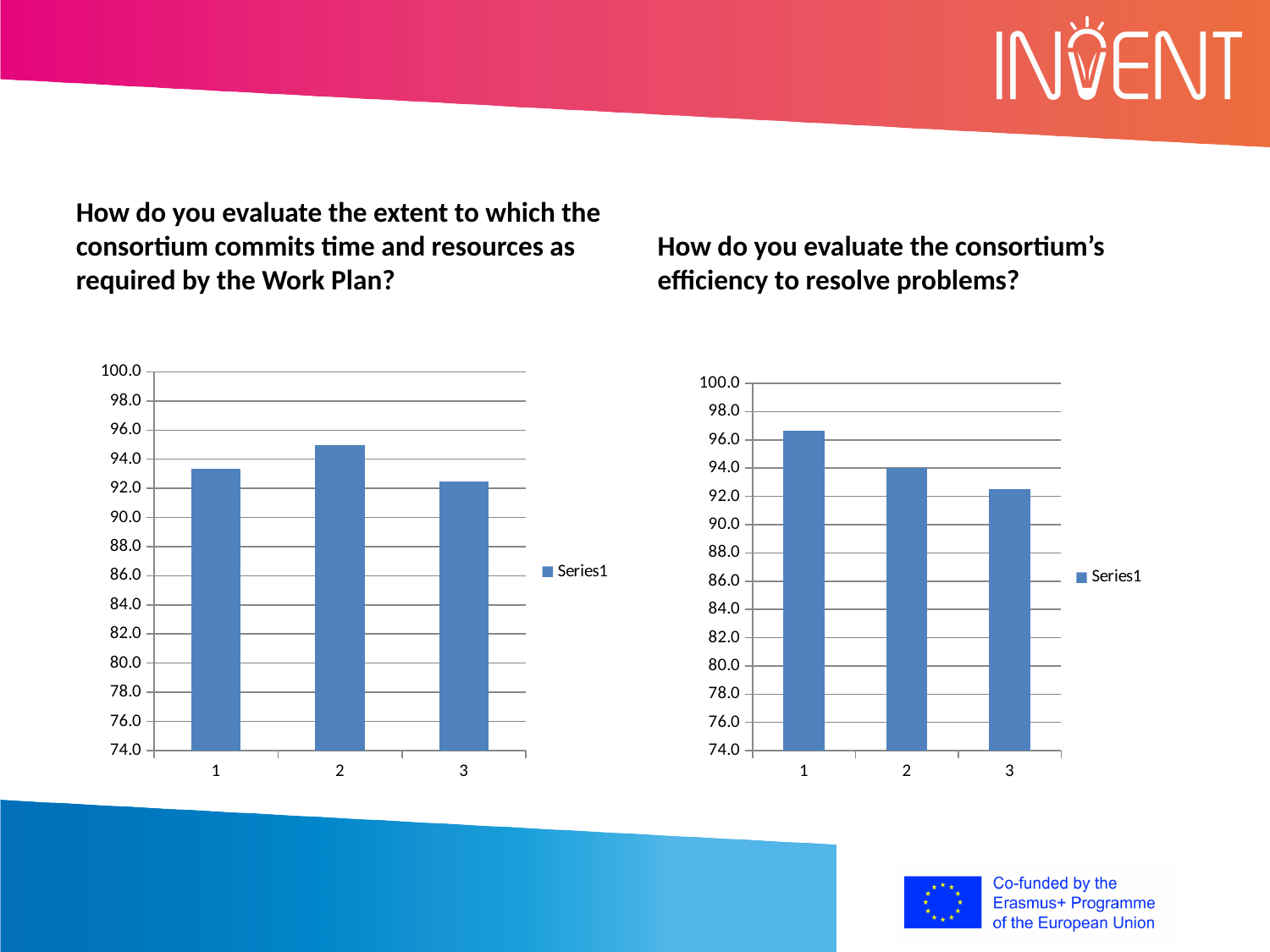
In the chart titled "How do you evaluate the consortium's efficiency to resolve problems?", which category has the highest value? 1 In the left chart (commits time and resources), is the value for category 2 greater or less than 94.0? greater In the left chart (commits time and resources), which is larger, the value for category 2 or category 3? category 2 In the chart titled "How do you evaluate the consortium's efficiency to resolve problems?", which category has the lowest value? 3 What kind of chart is used for "How do you evaluate the consortium's efficiency to resolve problems?"? bar chart How many categories are shown on the x axis of the right chart (efficiency to resolve problems)? 3 How many series does the legend of the left chart (commits time and resources) list? 1 In the right chart (efficiency to resolve problems), is the value for category 1 greater or less than 96.0? greater In the right chart (efficiency to resolve problems), which is larger, the value for category 1 or category 2? category 1 In the left chart (commits time and resources), is the value for category 3 greater or less than 94.0? less In the chart titled "How do you evaluate the extent to which the consortium commits time and resources as required by the Work Plan?", which category has the highest value? 2